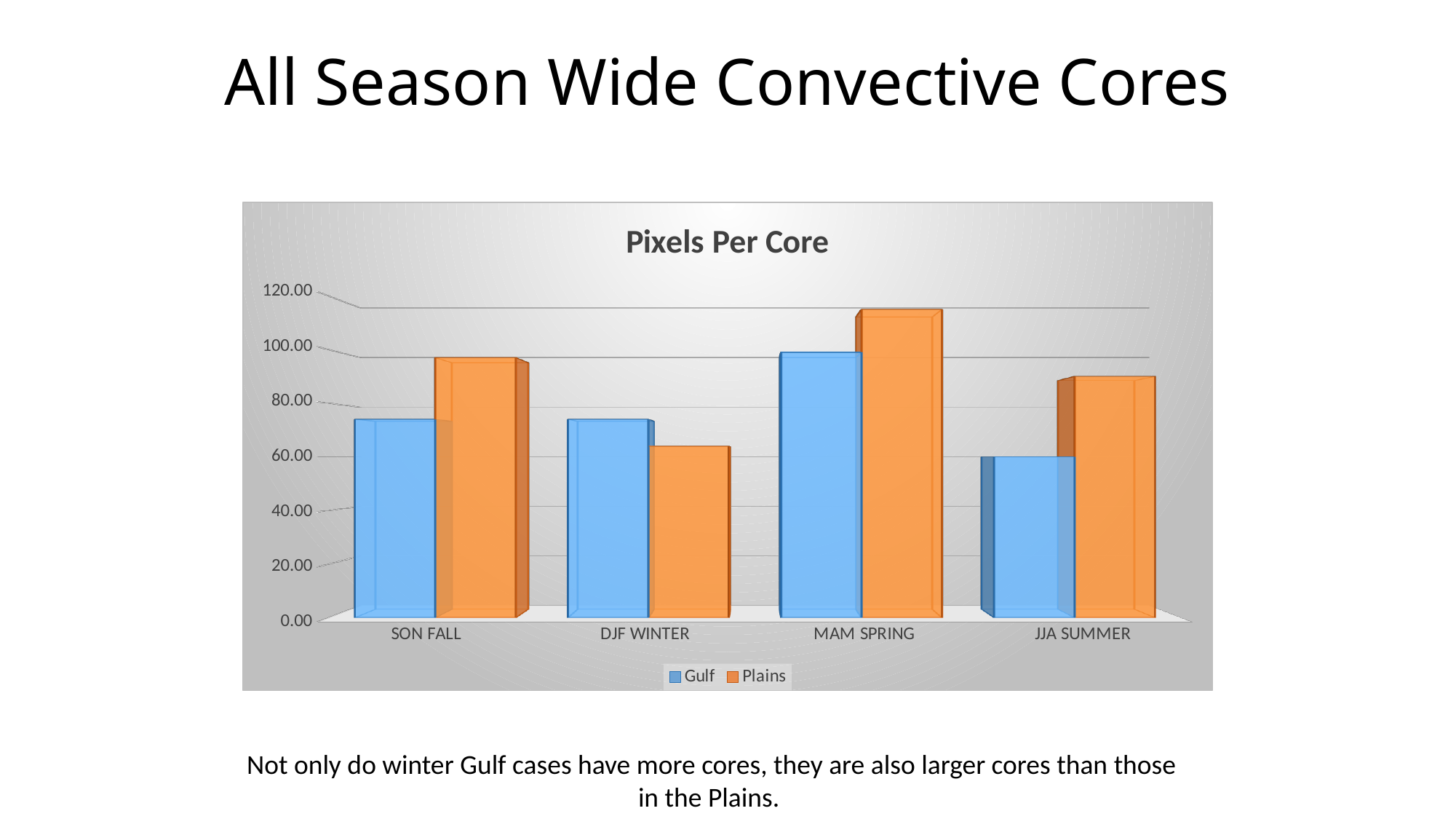
For DJF WINTER, which is larger, Gulf or Plains? Gulf Which season has the highest Gulf value? MAM SPRING Is the Gulf value for SON FALL greater or less than 80.00? less How many season categories are shown on the x axis? 4 Which series is shown in orange? Plains What is the title of the chart? Pixels Per Core For SON FALL, which is larger, Gulf or Plains? Plains Which season has the highest Plains value? MAM SPRING Is the Plains value for MAM SPRING greater or less than 100.00? greater Which season has the lowest Plains value? DJF WINTER How many series does the legend list? 2 What kind of chart is shown on the slide? Bar chart